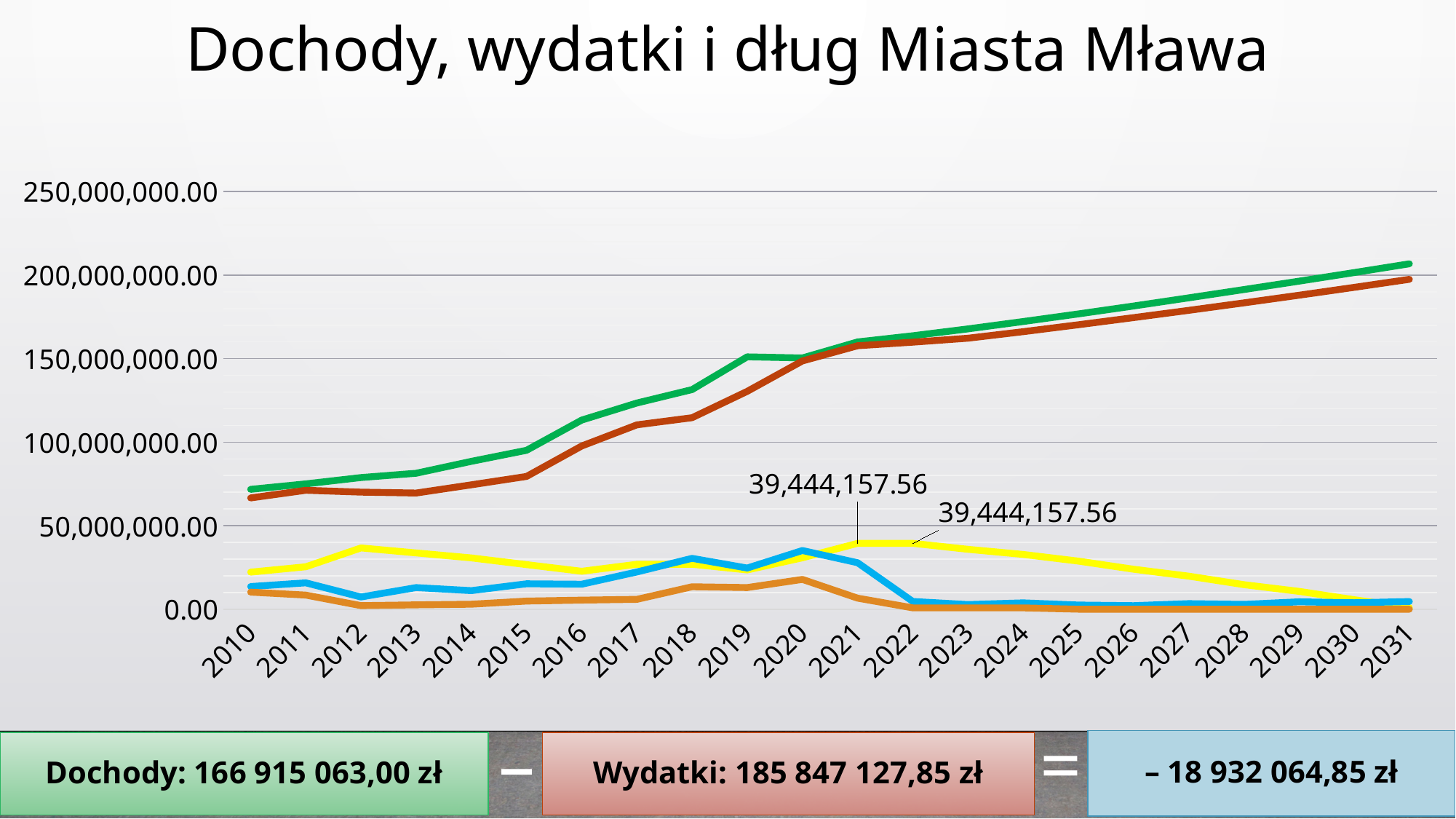
What value is labelled on the yellow line for 2022? 39,444,157.56 Is the value of the brown line in 2010 greater or less than 100,000,000.00? less How many years are shown along the x axis of the chart? 22 What kind of chart is shown on the slide? line chart Is the value of the yellow line in 2012 greater or less than 50,000,000.00? less In 2031, which line is higher, the green line or the brown line? green line Does the green line rise or fall from 2010 to 2031? rises In which year does the green line reach its highest value? 2031 What is the title of the chart? Dochody, wydatki i dług Miasta Mława What value is labelled on the yellow line for 2021? 39,444,157.56 In 2019, which line is higher, the green line or the brown line? green line Is the value of the green line in 2031 greater or less than 200,000,000.00? greater